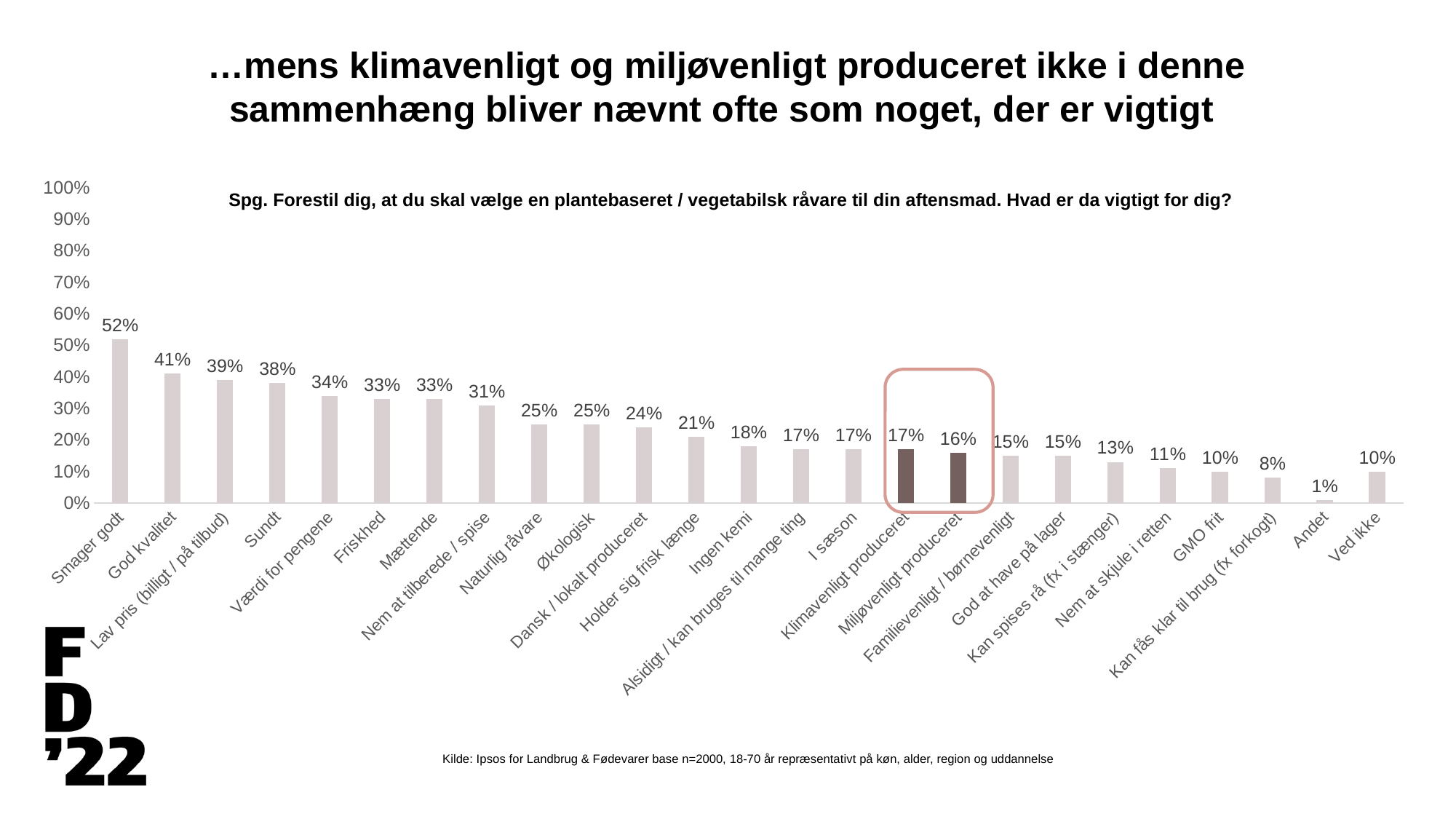
What is the value for Smager godt? 52% What is the difference between Smager godt and God kvalitet? 11% What kind of chart is shown? Bar chart Which is larger, Sundt or Friskhed? Sundt What is the value for Miljøvenligt produceret? 16% What is the value for Økologisk? 25% Do the values generally rise or fall from left to right along the x axis? Fall What is the value for Klimavenligt produceret? 17% Which two bars are highlighted in a darker colour and outlined with a box? Klimavenligt produceret and Miljøvenligt produceret Which category has the lowest value? Andet Which category has the highest value? Smager godt How many categories are shown on the x axis? 25